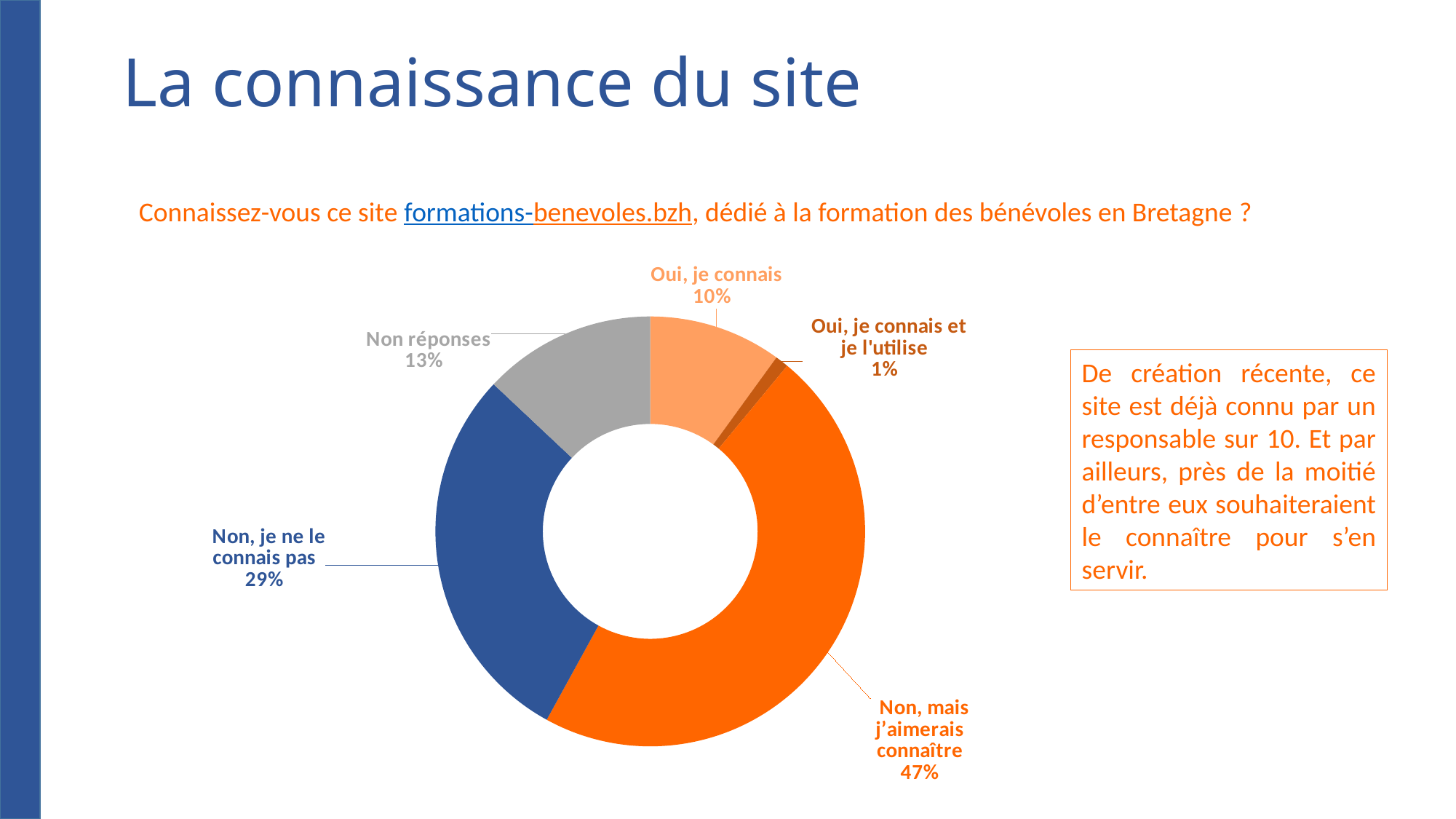
What share of respondents answered "Non, je ne le connais pas"? 29% Which is larger: the share for "Non réponses" or the share for "Oui, je connais"? Non réponses Which response category has the smallest share? Oui, je connais et je l'utilise What is the difference in percentage points between "Non, mais j'aimerais connaître" and "Non, je ne le connais pas"? 18 percentage points How many categories does the chart show? 5 What share of respondents answered "Non, mais j'aimerais connaître"? 47% What share of respondents answered "Oui, je connais"? 10% What kind of chart is shown on the slide? Doughnut (pie) chart What colour is the "Non, je ne le connais pas" slice? Blue Which response category has the largest share? Non, mais j'aimerais connaître What share of respondents answered "Oui, je connais et je l'utilise"? 1% What share is labelled "Non réponses"? 13%